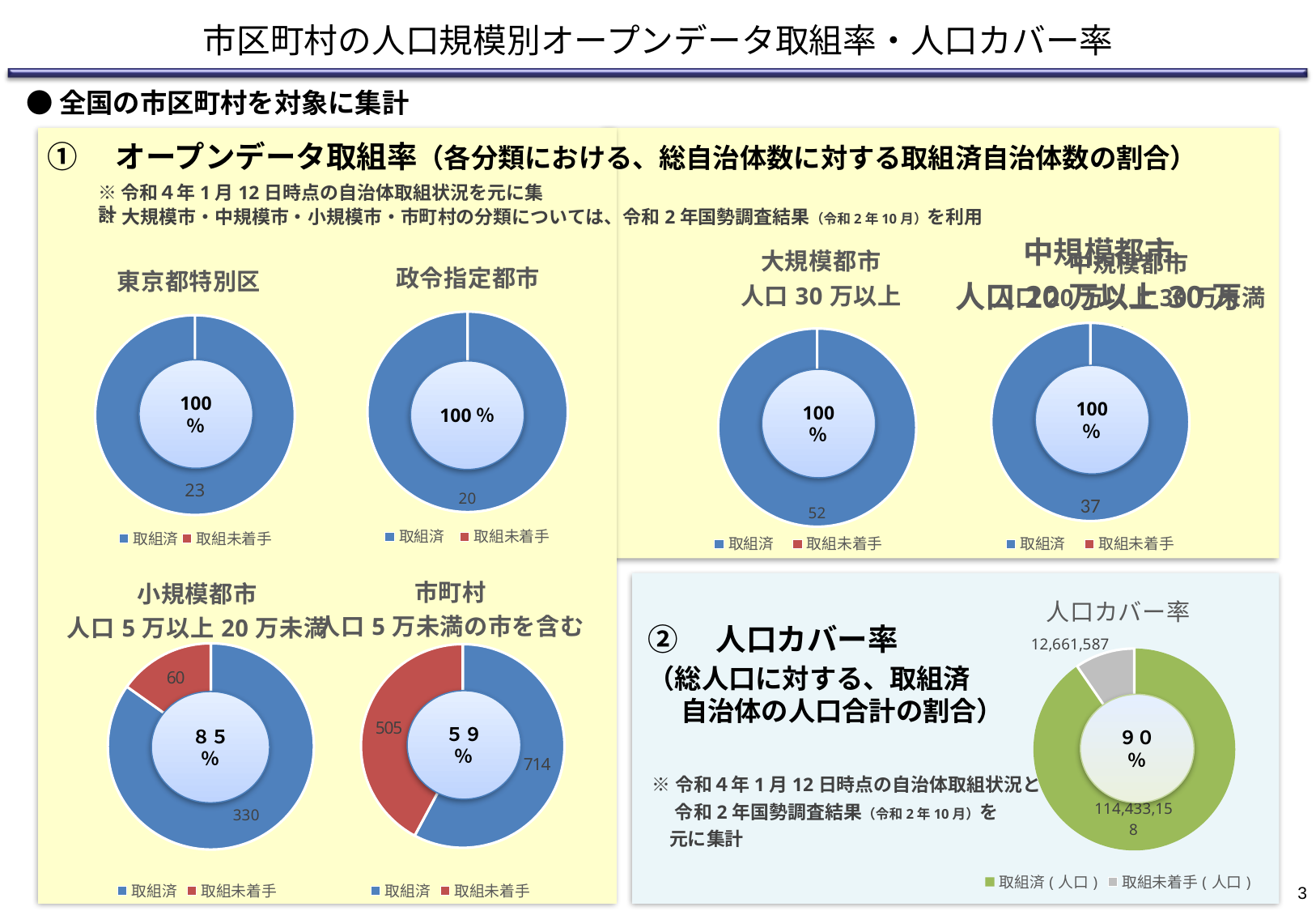
In the 市町村 chart, what is the total of the two segments (取組済 plus 取組未着手)? 1219 What kind of chart is used for 人口カバー率? Doughnut chart In the 小規模都市 chart, what is the value for 取組未着手? 60 How many series does the legend of the 小規模都市 chart list? 2 In the 市町村 chart, what is the value for 取組済? 714 In the 小規模都市 chart, what is the total of the two segments (取組済 plus 取組未着手)? 390 In the 東京都特別区 chart, what is the number of 取組済 municipalities shown on the doughnut? 23 In the 人口カバー率 chart, what percentage is shown in the centre? 90% In the 市町村 chart, which segment is larger, 取組済 or 取組未着手? 取組済 In the 政令指定都市 chart, what percentage is shown in the centre? 100% In the 人口カバー率 chart, what is the value for 取組未着手 (人口)? 12,661,587 In the 大規模都市 (人口30万以上) chart, what is the number of 取組済 municipalities shown? 52